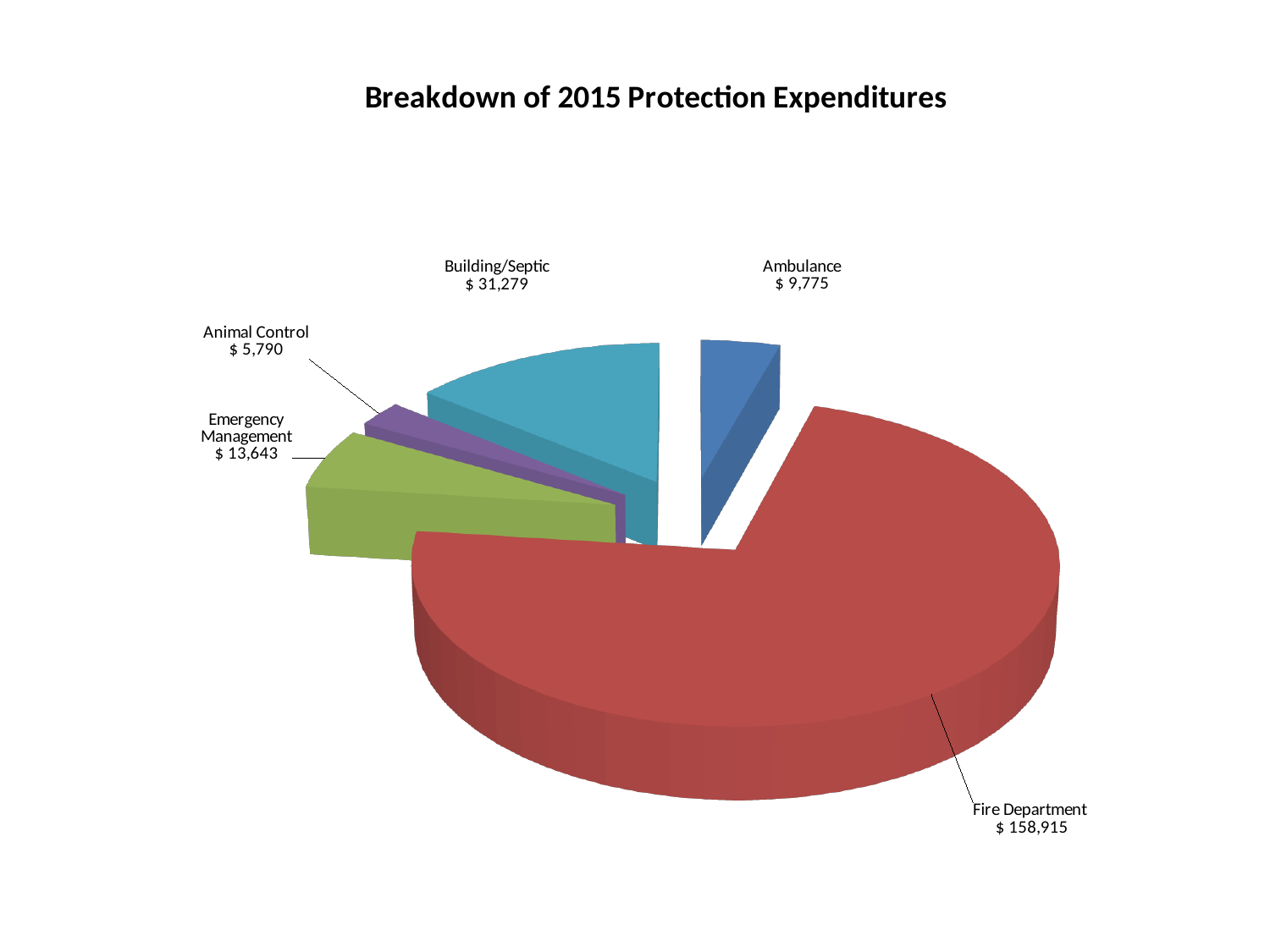
What is the value for Ambulance? $ 9,775 What is the difference between the Fire Department and Building/Septic expenditures? $ 127,636 What is the value for Building/Septic? $ 31,279 What is the value for Emergency Management? $ 13,643 What is the difference between the Emergency Management and Animal Control expenditures? $ 7,853 What is the title of the chart? Breakdown of 2015 Protection Expenditures How many categories are shown in the pie chart? 5 Which category has the highest expenditure? Fire Department What colour is the Fire Department slice? Red Which is larger, the Ambulance expenditure or the Emergency Management expenditure? Emergency Management Which category has the lowest expenditure? Animal Control What type of chart is shown on the slide? Pie chart